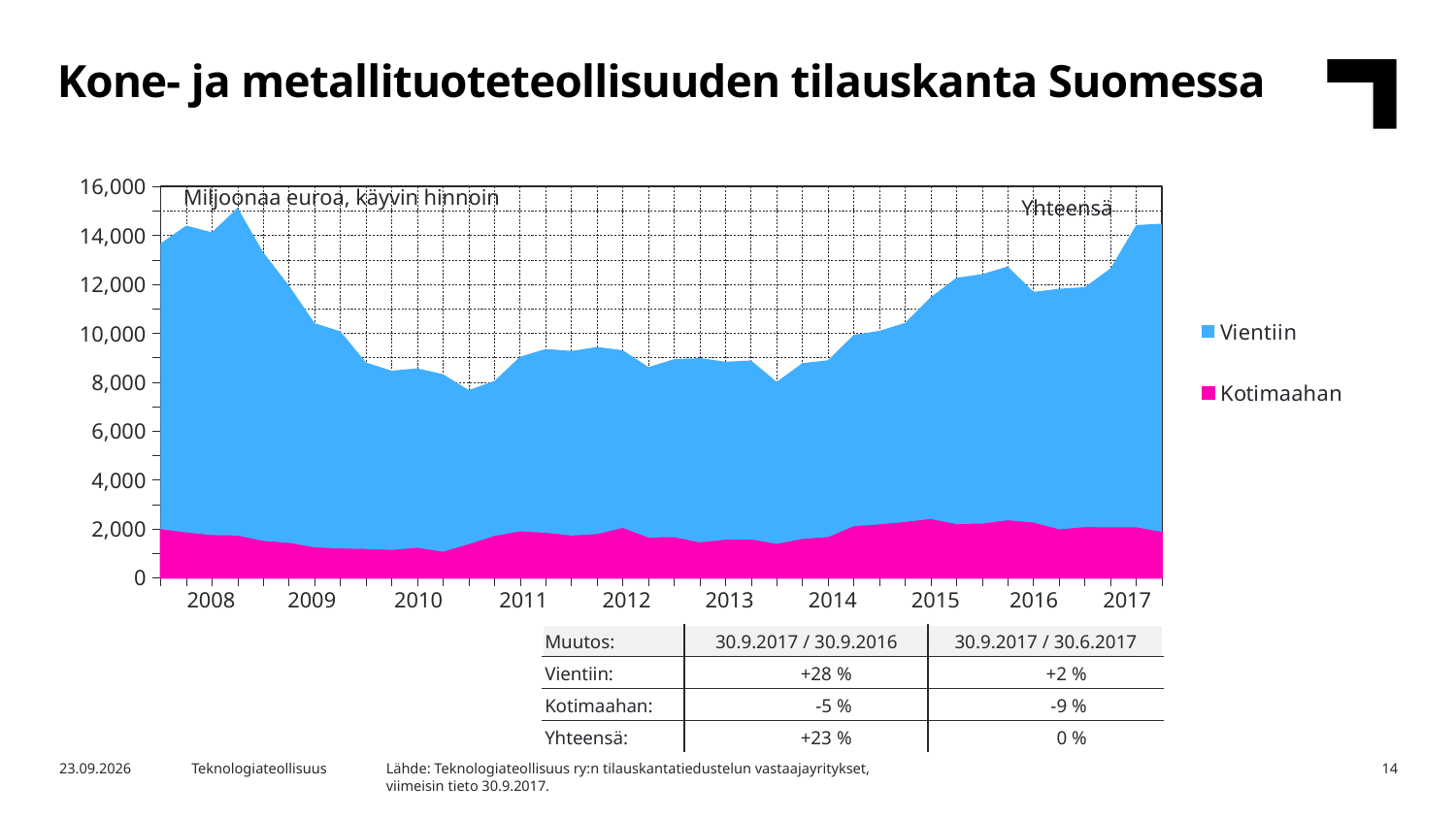
Is the Kotimaahan value in 2010 greater or less than 2,000? less How many years are labelled on the x axis of the chart? 10 What unit label is printed inside the chart area? Miljoonaa euroa, käyvin hinnoin How many series does the chart legend list? 2 Which series is larger throughout the chart, Vientiin or Kotimaahan? Vientiin Is the total (Yhteensä) value at the start of 2008 greater or less than 12,000? greater What kind of chart is shown on the slide? Stacked area chart Does the total (Yhteensä) value rise or fall from 2008 to 2010? fall Does the total (Yhteensä) value rise or fall from 2014 to 2017? rise What are the two series named in the chart legend? Vientiin and Kotimaahan Is the total (Yhteensä) value at the end of 2017 greater or less than 12,000? greater